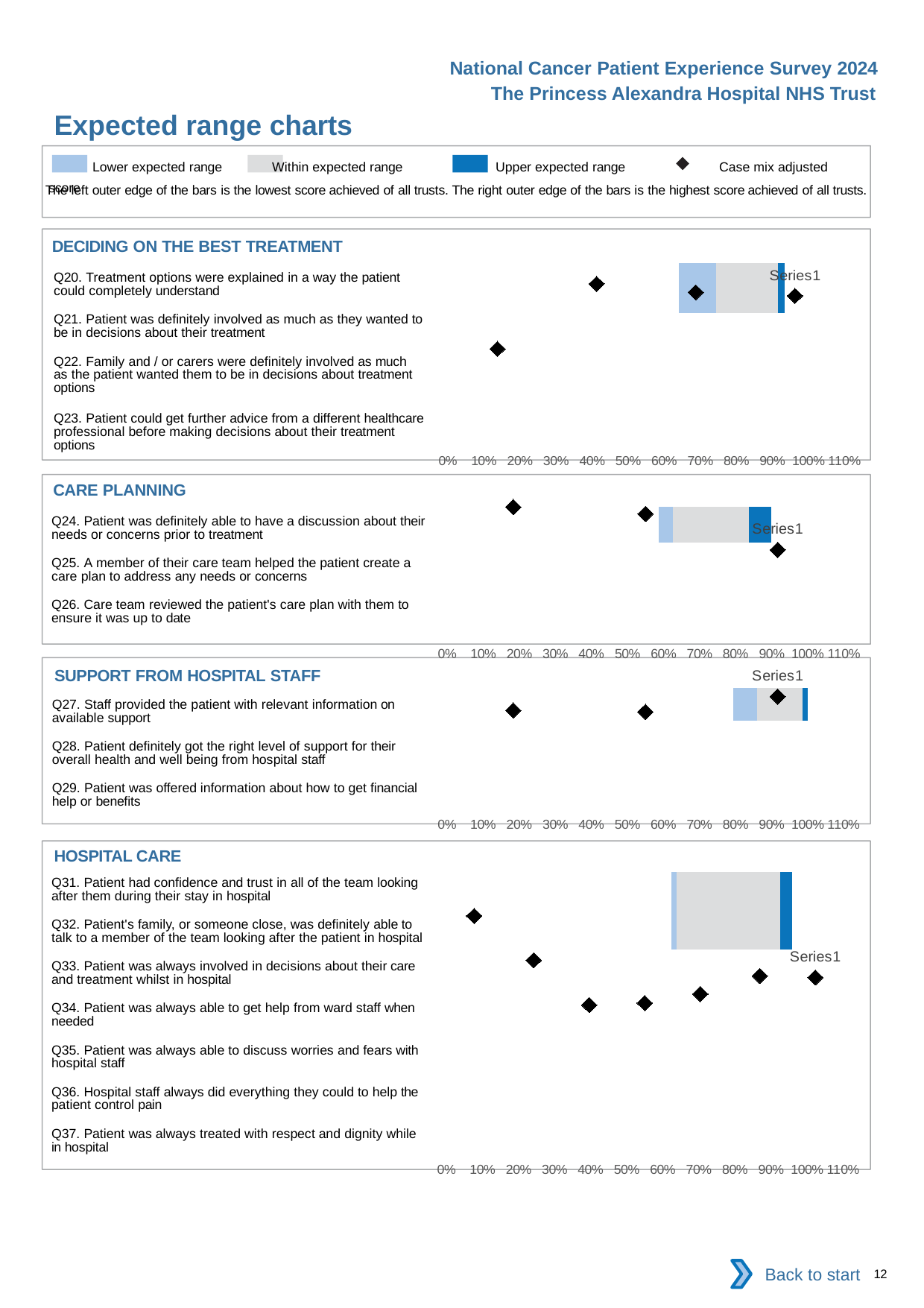
What is the highest tick label on the x axis of the HOSPITAL CARE chart? 110% How many questions are listed in the CARE PLANNING section? 3 According to the legend, what does the diamond marker represent? Case mix adjusted score Which section on the slide lists the most questions? HOSPITAL CARE How many questions are listed in the SUPPORT FROM HOSPITAL STAFF section? 3 How many diamond markers are plotted in the HOSPITAL CARE chart? 7 What kind of chart is used in each section of the slide? bar chart How many entries does the legend at the top of the slide list? 4